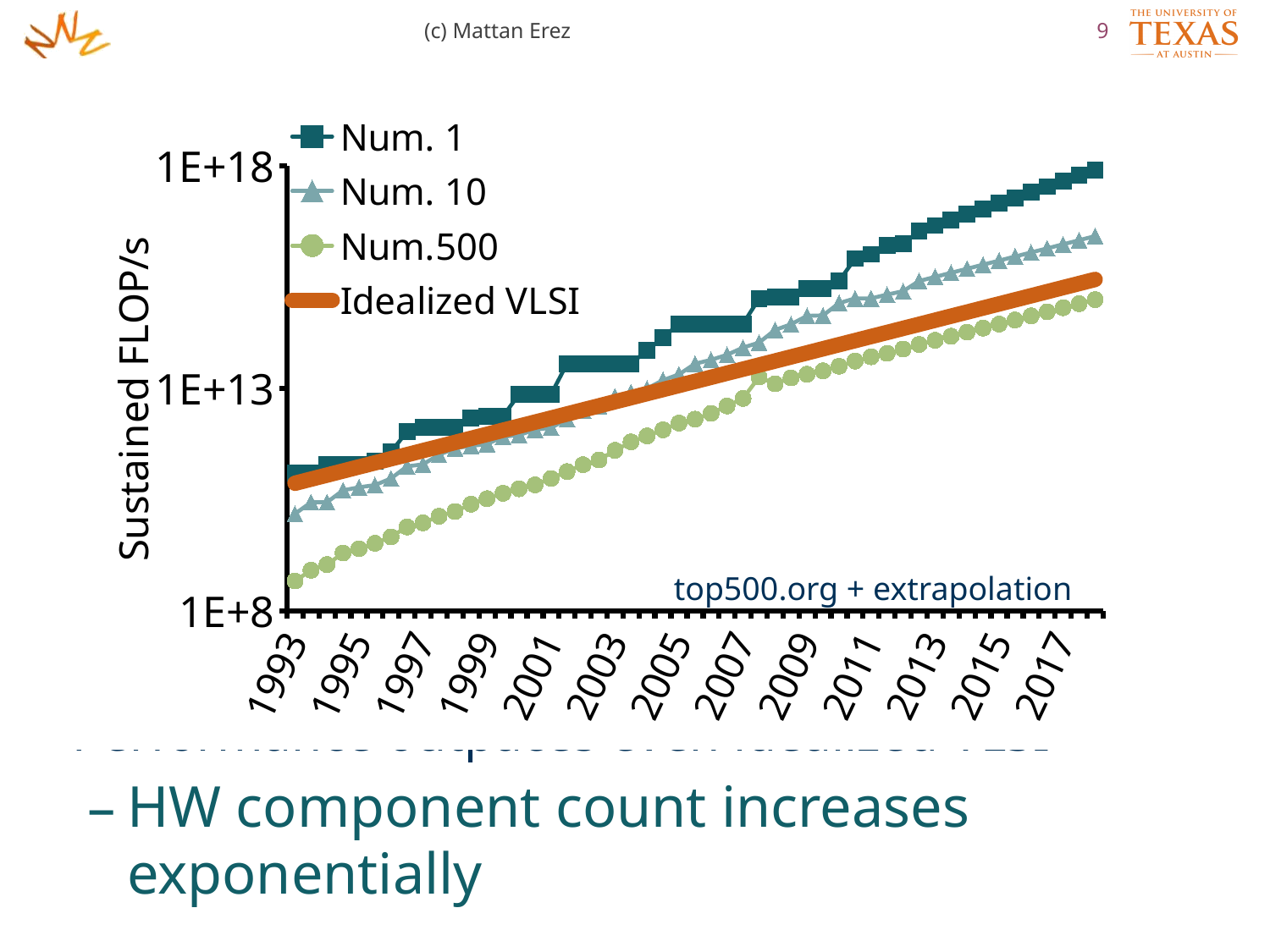
How many series does the legend list? 4 What source note is printed inside the chart area? top500.org + extrapolation In 2017, which is larger: the Num. 1 value or the Num.500 value? Num. 1 Does the Num. 1 series rise or fall from 1993 to 2017? rise Which series has the lowest value in 1993? Num.500 What kind of chart is shown on the slide? line chart How many year labels are shown on the x axis? 13 In 1993, which is larger: the Num. 10 value or the Num.500 value? Num. 10 Which series has the highest value in 2017? Num. 1 Is the value for Num. 1 in 2017 greater or less than 1E+13? greater What is the label on the y axis of the chart? Sustained FLOP/s Is the value for Num.500 in 1993 greater or less than 1E+13? less